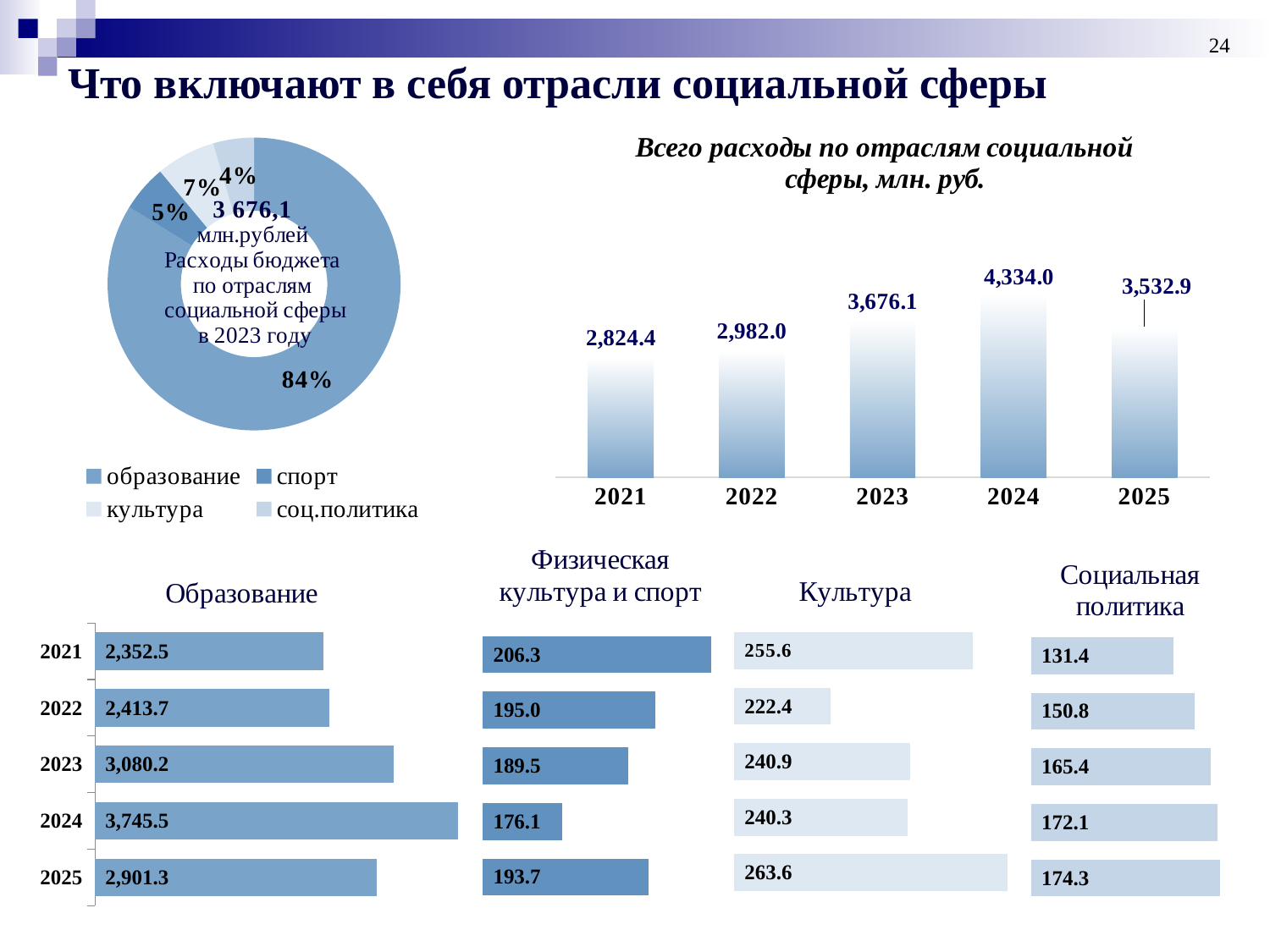
On the chart 'Всего расходы по отраслям социальной сферы, млн. руб.', how many years are shown? 5 On the 'Образование' chart, what is the value for 2023? 3,080.2 On the 'Социальная политика' chart, do the values rise or fall from 2021 to 2025? rise On the donut chart at the top left, how many entries does the legend list? 4 What kind of chart is the 'Образование' chart? bar chart On the 'Социальная политика' chart, what is the difference between the 2025 and 2021 values? 42.9 On the chart 'Всего расходы по отраслям социальной сферы, млн. руб.', what is the value for 2024? 4,334.0 On the chart 'Всего расходы по отраслям социальной сферы, млн. руб.', which year has the highest value? 2024 On the 'Физическая культура и спорт' chart, which year has the lowest value? 2024 On the donut chart at the top left, what share does 'образование' have? 84% On the chart 'Всего расходы по отраслям социальной сферы, млн. руб.', what is the difference between the 2024 and 2023 values? 657.9 On the 'Культура' chart, which is larger, the value for 2021 or the value for 2025? 2025